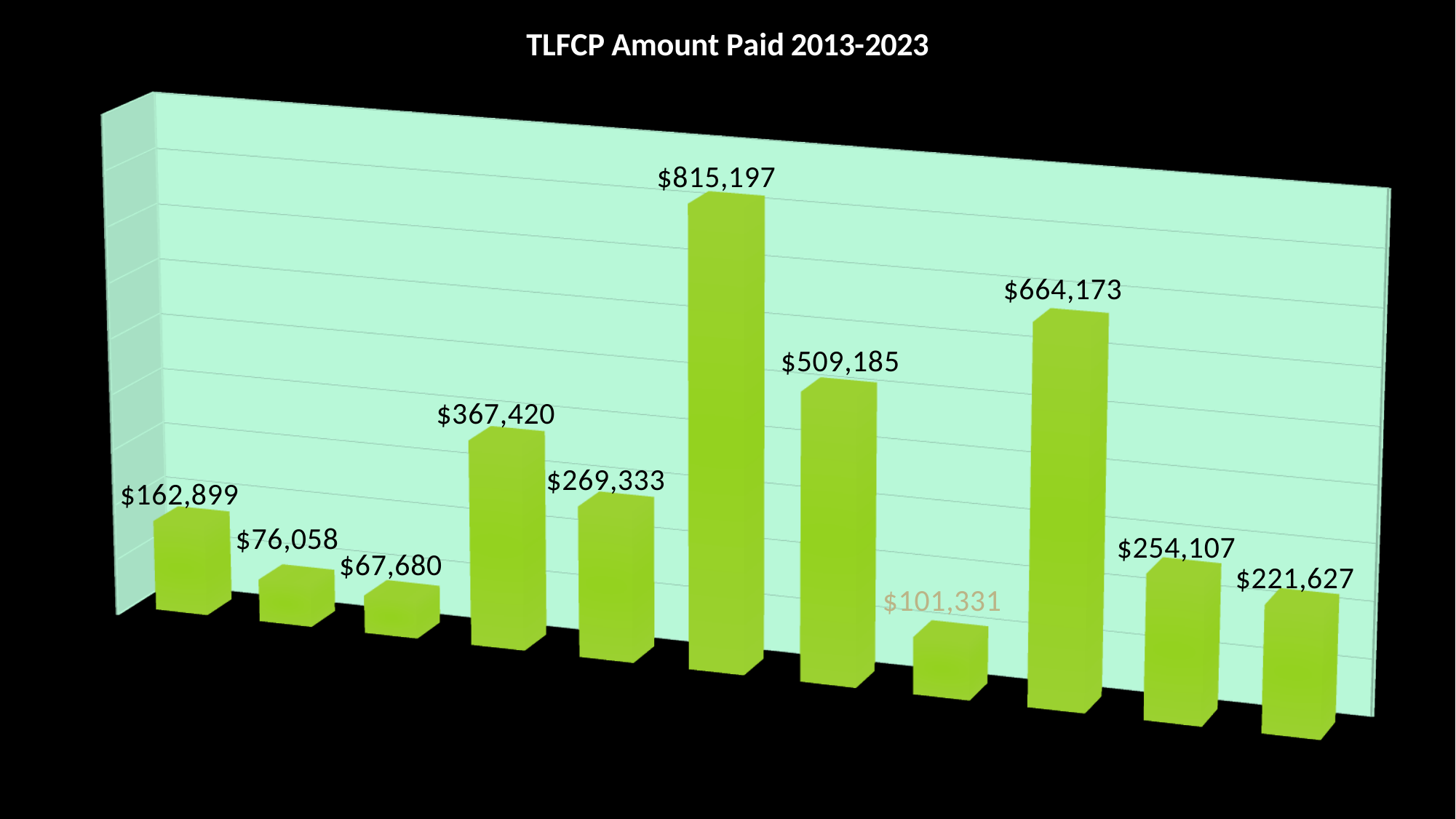
What is the difference between the second bar from the left ($76,058) and the third bar from the left ($67,680)? $8,378 What is the lowest value shown in the chart? $67,680 What is the title of the chart? TLFCP Amount Paid 2013-2023 Which is larger, the fourth bar from the left or the fifth bar from the left? the fourth bar ($367,420) What is the value labelled on the last bar on the right? $221,627 How many bars are plotted in the chart? 11 What kind of chart is shown on the slide? bar chart What is the difference between the highest bar ($815,197) and the second-highest bar ($664,173)? $151,024 What is the value labelled on the eighth bar from the left? $101,331 What is the value labelled on the first bar from the left? $162,899 What is the highest value shown in the chart? $815,197 What is the value labelled on the fourth bar from the left? $367,420